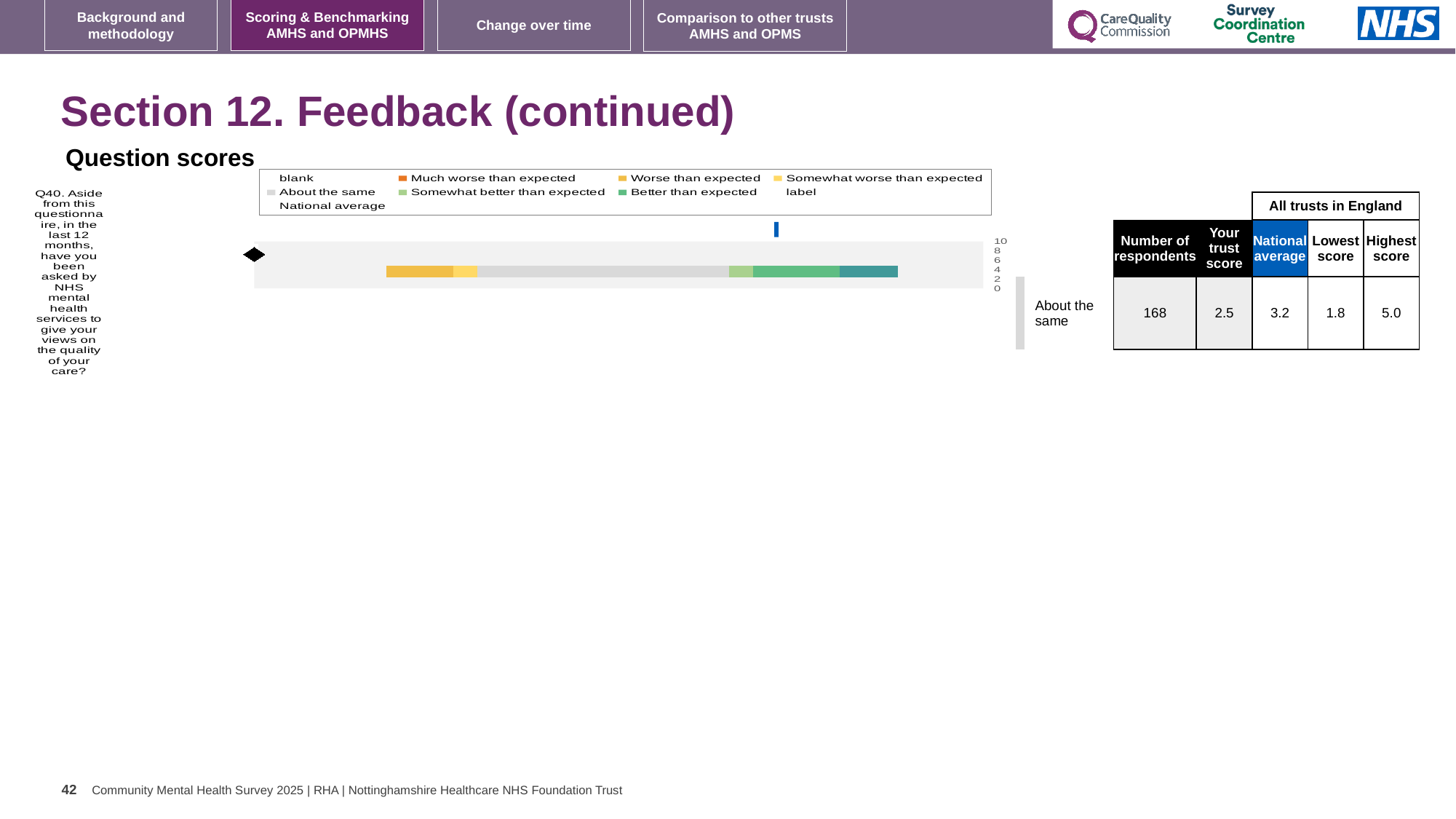
What is the difference between the national average and the trust's score for Q40? 0.7 Which is larger for Q40, the trust's score or the national average? national average How many questions (categories) are plotted in the Question scores chart? 1 In the table beside the chart, what is the national average for Q40? 3.2 What kind of chart is used to show the Q40 question score? bar chart In the table beside the chart, what is the number of respondents for Q40? 168 Which question is plotted in the Question scores chart? Q40 In the table beside the chart, what is the highest score among all trusts in England for Q40? 5.0 In the table beside the chart, what is the trust's score for Q40? 2.5 What colour does the legend use for 'About the same'? grey According to the label next to the chart, how does the trust's Q40 score compare with expectations? About the same In the table beside the chart, what is the lowest score among all trusts in England for Q40? 1.8